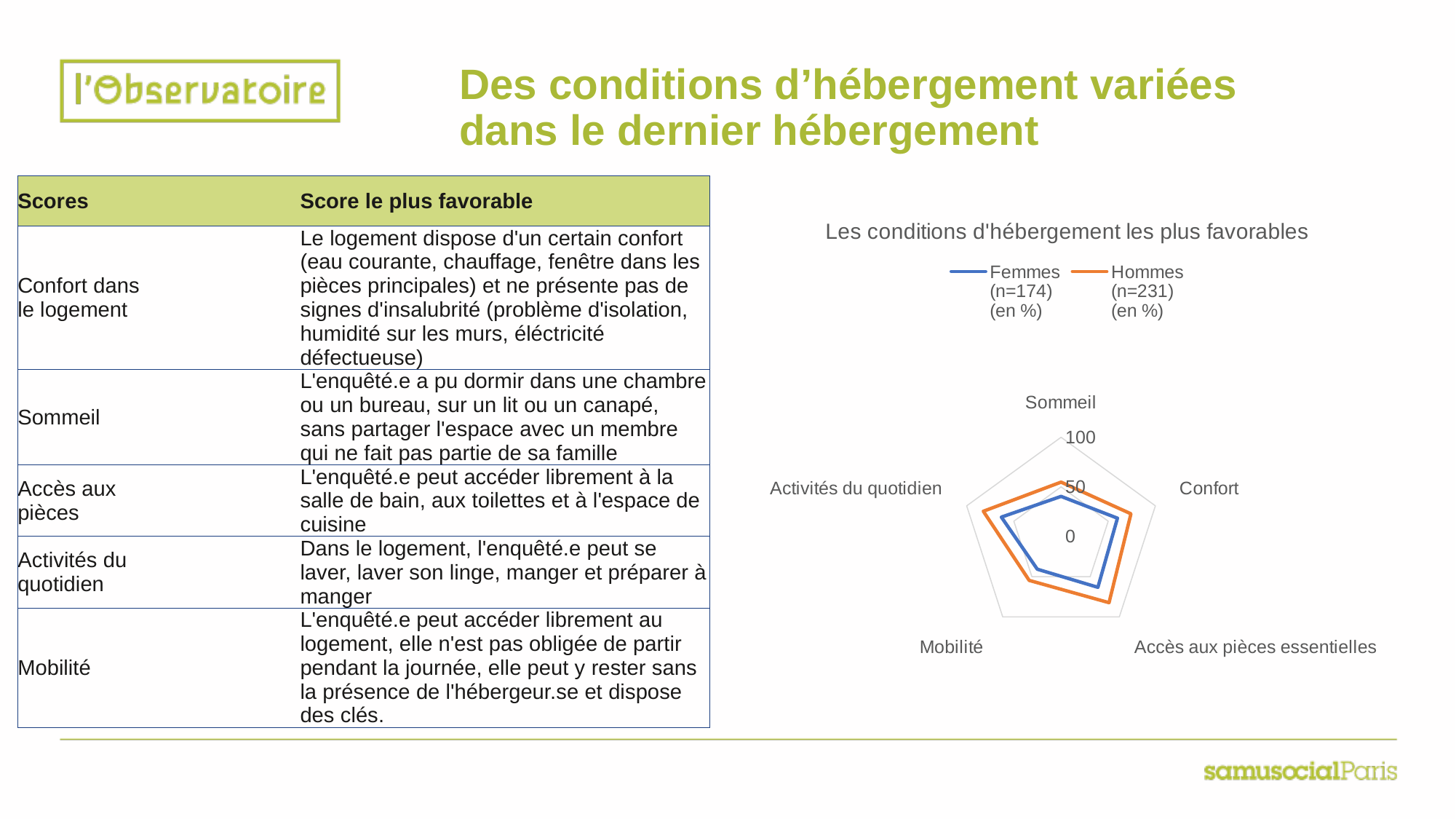
Is the value for Hommes on the Activités du quotidien axis greater or less than 50? greater What is the title of the chart? Les conditions d'hébergement les plus favorables What kind of chart is shown on the slide? Radar chart How many categories (axes) does the radar chart have? 5 Is the value for Hommes on the Confort axis greater or less than 50? greater According to the legend, how many women (Femmes) are in the sample? n=174 Is the value for Hommes on the Mobilité axis greater or less than 50? greater On the Accès aux pièces essentielles axis, which series has the larger value, Femmes or Hommes? Hommes On the Mobilité axis, which series has the larger value, Femmes or Hommes? Hommes How many series does the legend of the chart list? 2